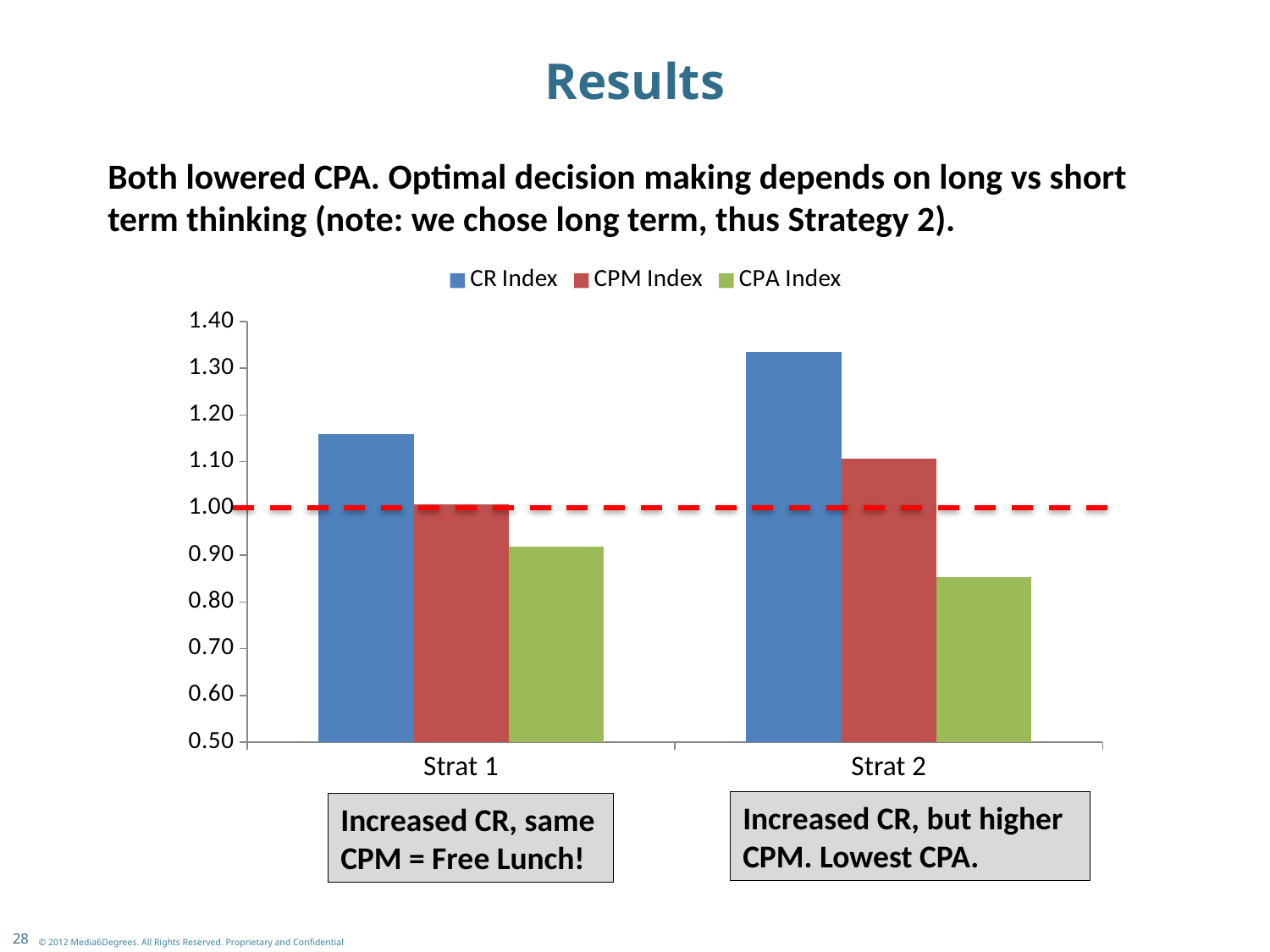
What kind of chart is shown on the slide? bar chart Which strategy has the higher CR Index, Strat 1 or Strat 2? Strat 2 How many categories are shown on the x axis of the chart? 2 Which strategy has the lower CPA Index, Strat 1 or Strat 2? Strat 2 At what value on the y axis is the red dashed horizontal line drawn? 1.00 Is the CPA Index value for Strat 2 greater or less than 0.90? less Which series has the tallest bar in the chart? CR Index (Strat 2) Is the CPM Index value for Strat 2 greater or less than 1.00? greater Which bar is the lowest in the chart? CPA Index for Strat 2 Is the CR Index value for Strat 2 greater or less than 1.20? greater How many series does the chart legend list? 3